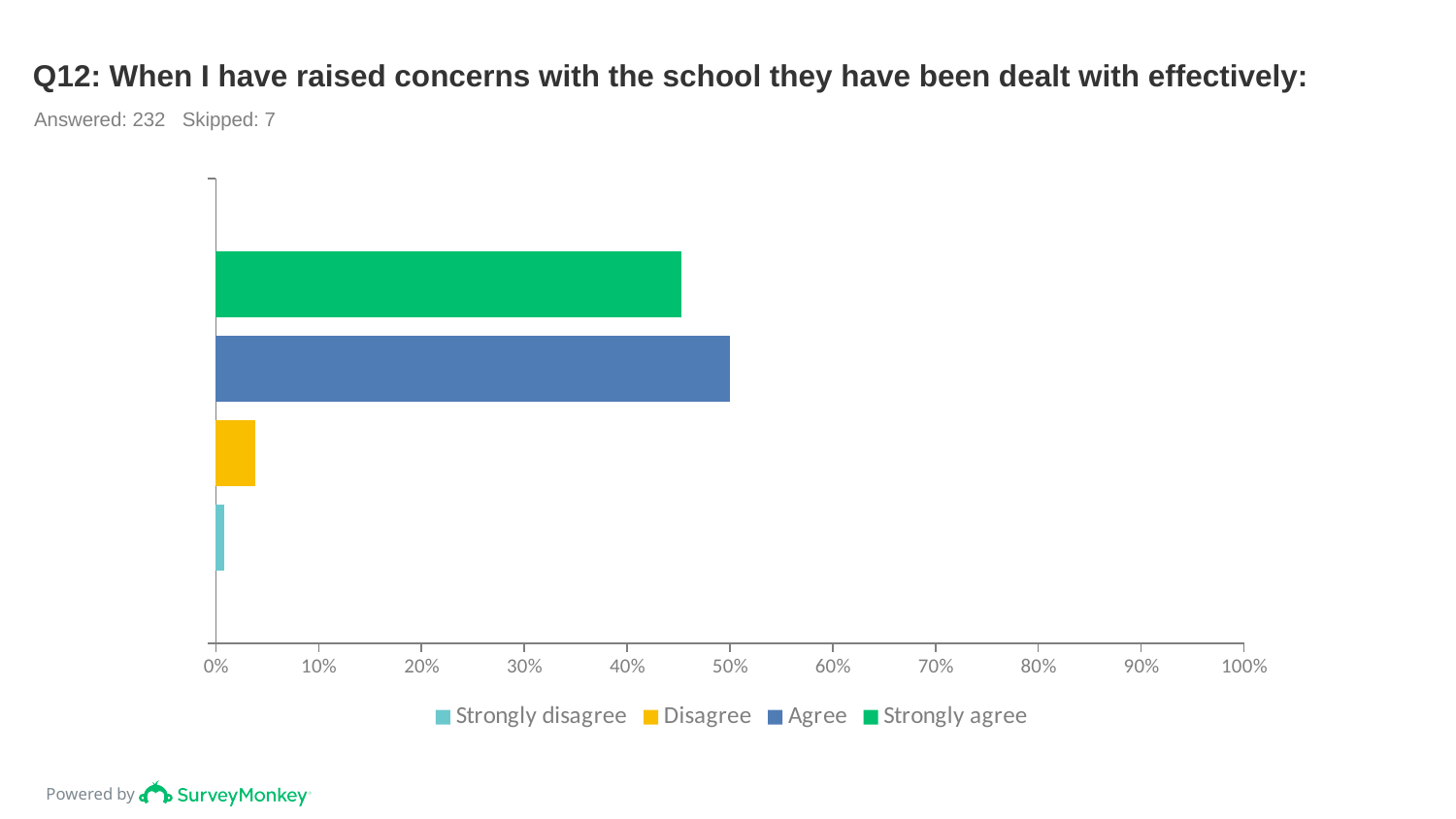
Is the value for Agree greater or less than 40%? greater Which response option has the longest bar? Agree What colour is the bar for Strongly agree? Green What kind of chart is shown on the slide? Bar chart Which response option has the shortest bar? Strongly disagree Is the value for Strongly agree greater or less than 50%? less Is the value for Disagree greater or less than 10%? less How many bars are plotted in the chart? 4 How many entries does the legend list? 4 Which is larger, the value for Agree or the value for Strongly agree? Agree Which is larger, the value for Disagree or the value for Strongly disagree? Disagree